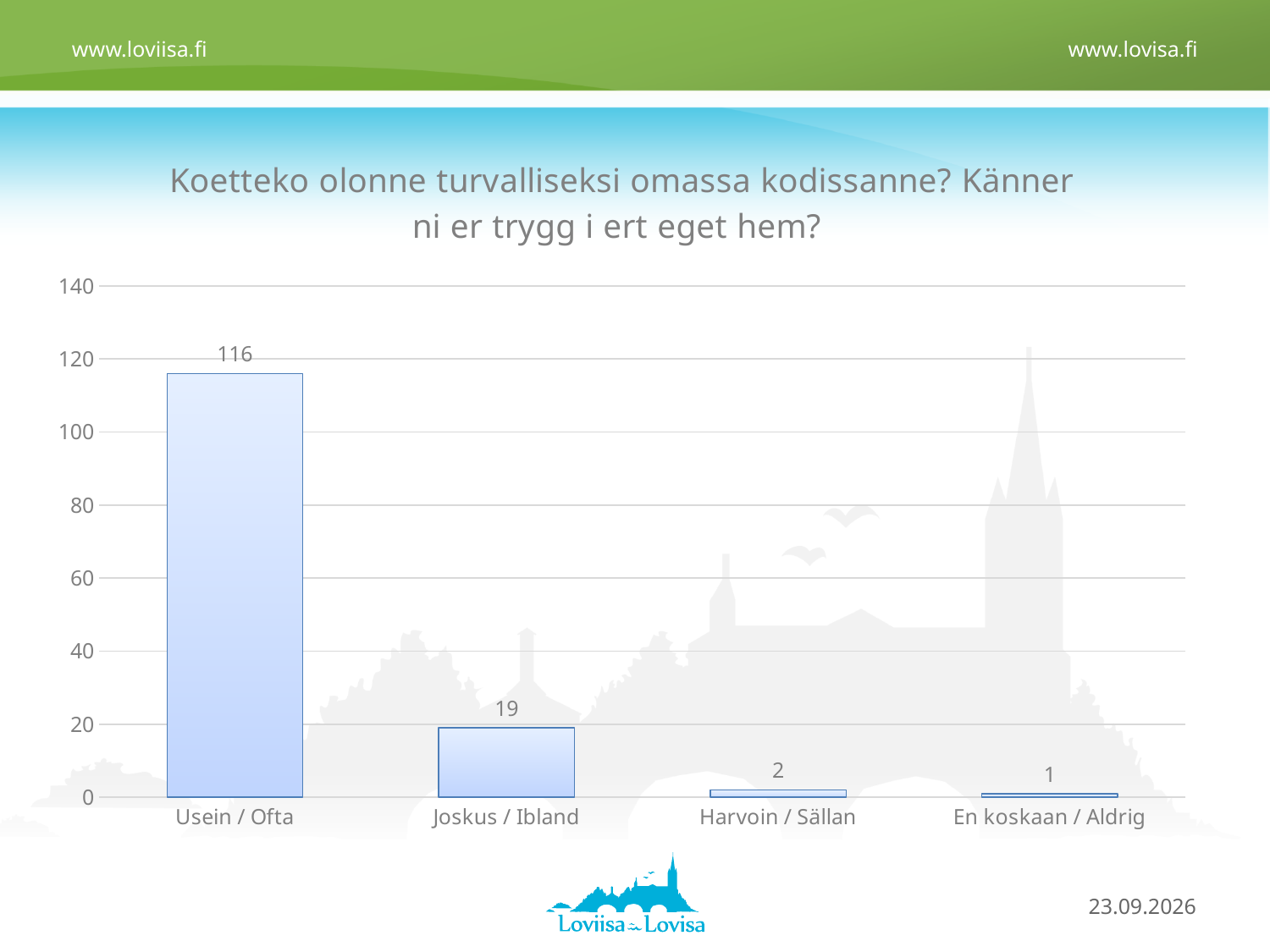
Which category has the lowest value? En koskaan / Aldrig How many categories are shown on the x axis? 4 Do the values rise or fall from left to right along the x axis? fall Is the value for Usein / Ofta greater or less than 100? greater What kind of chart is shown on the slide? bar chart Which is larger, the value for Joskus / Ibland or the value for Harvoin / Sällan? Joskus / Ibland What is the value for Joskus / Ibland? 19 What is the value for Harvoin / Sällan? 2 What is the difference between the values for Usein / Ofta and Joskus / Ibland? 97 What is the value for Usein / Ofta? 116 What is the value for En koskaan / Aldrig? 1 Which category has the highest value? Usein / Ofta